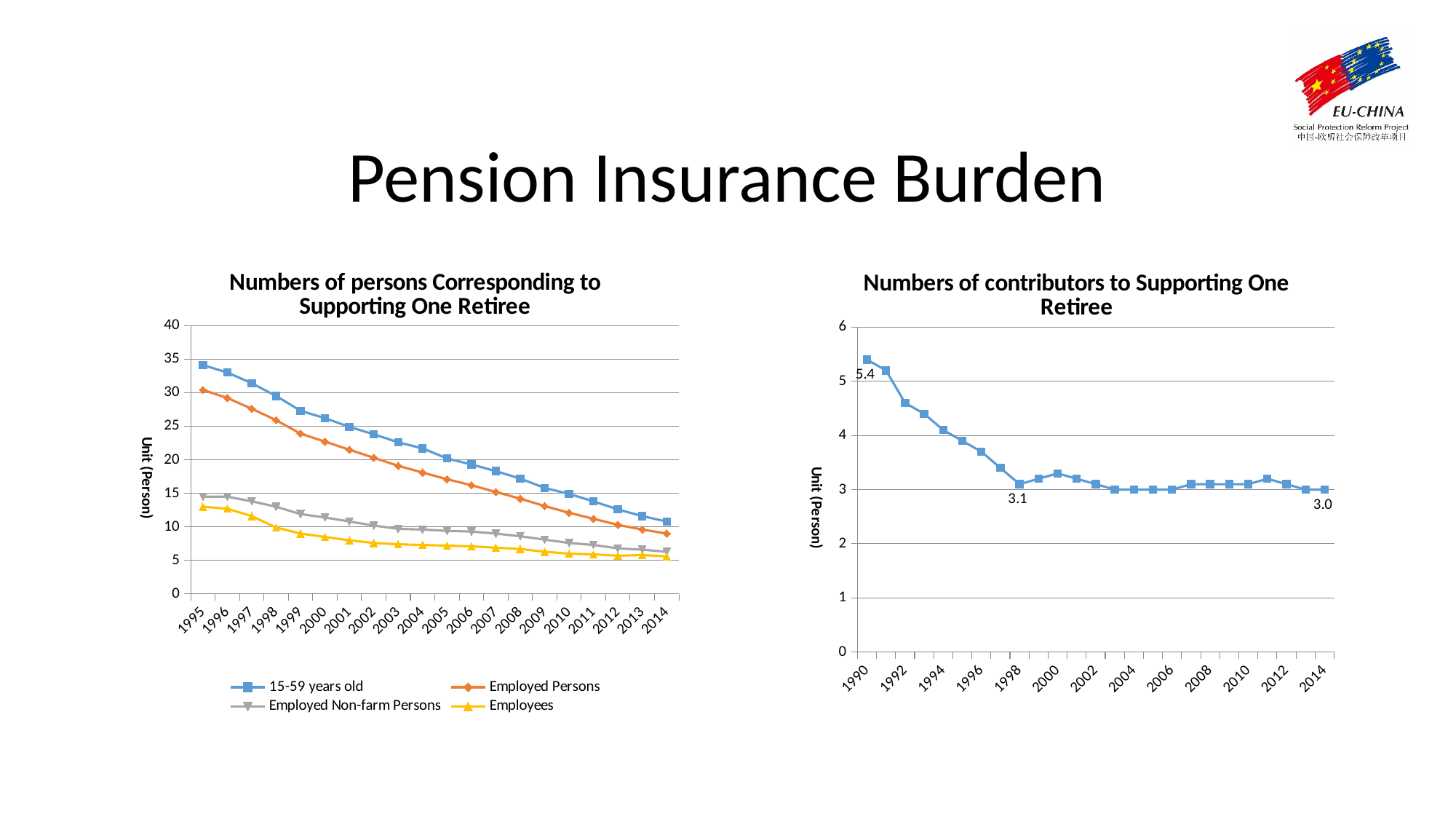
In the chart 'Numbers of contributors to Supporting One Retiree', do the values generally rise or fall from 1990 to 2014? fall How many series does the legend of the chart 'Numbers of persons Corresponding to Supporting One Retiree' list? 4 How many years are plotted on the x axis of the chart 'Numbers of persons Corresponding to Supporting One Retiree'? 20 In the chart 'Numbers of contributors to Supporting One Retiree', what is the difference between the 1990 value and the 2014 value? 2.4 In the chart 'Numbers of persons Corresponding to Supporting One Retiree', is the value for '15-59 years old' in 1995 greater or less than 30? greater In the chart 'Numbers of contributors to Supporting One Retiree', what is the value for 2014? 3.0 In the chart 'Numbers of contributors to Supporting One Retiree', what is the value for 1990? 5.4 In the chart 'Numbers of persons Corresponding to Supporting One Retiree', is the value for 'Employees' in 2014 greater or less than 10? less What kind of chart is 'Numbers of persons Corresponding to Supporting One Retiree'? line chart In the chart 'Numbers of persons Corresponding to Supporting One Retiree', which series has the highest value in 1995? 15-59 years old In the chart 'Numbers of persons Corresponding to Supporting One Retiree', which is larger in 2005: 'Employed Persons' or 'Employees'? Employed Persons In the chart 'Numbers of contributors to Supporting One Retiree', what is the value for 1998? 3.1